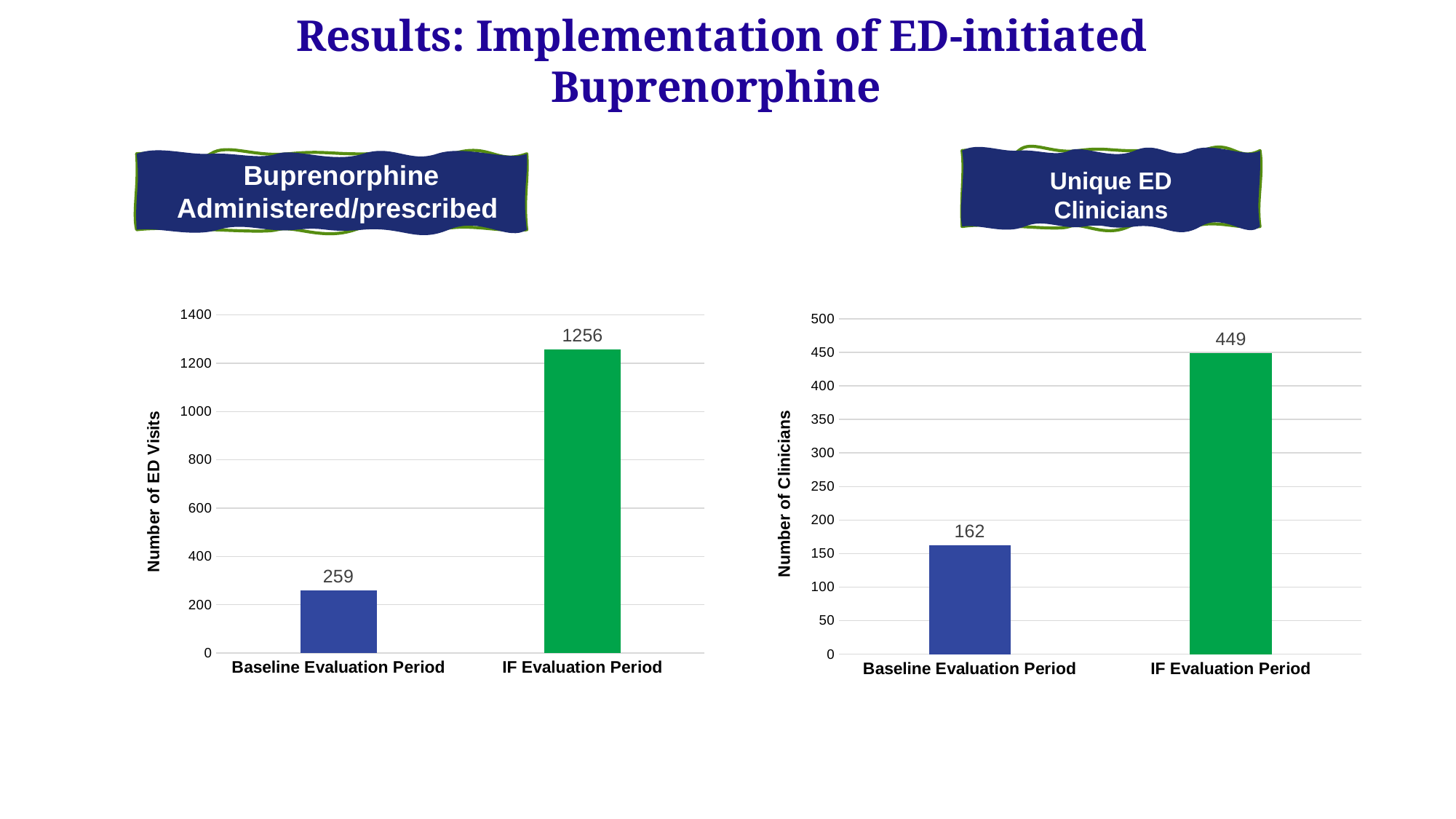
In the Unique ED Clinicians chart, which period has the lowest number of clinicians? Baseline Evaluation Period In the Unique ED Clinicians chart, is the value for the Baseline Evaluation Period greater or less than 200? less How many categories are shown on the x axis of the Buprenorphine Administered/prescribed chart? 2 In the Buprenorphine Administered/prescribed chart, which period has the highest number of ED visits? IF Evaluation Period In the Unique ED Clinicians chart, what is the value for the Baseline Evaluation Period? 162 What is the y-axis label of the Buprenorphine Administered/prescribed chart? Number of ED Visits In the Unique ED Clinicians chart, what is the value for the IF Evaluation Period? 449 In the Buprenorphine Administered/prescribed chart, what is the difference between the IF Evaluation Period and the Baseline Evaluation Period? 997 What kind of chart is the Unique ED Clinicians chart? bar chart In the Buprenorphine Administered/prescribed chart, what is the value for the IF Evaluation Period? 1256 In the Unique ED Clinicians chart, what is the difference between the IF Evaluation Period and the Baseline Evaluation Period? 287 In the Buprenorphine Administered/prescribed chart, what is the value for the Baseline Evaluation Period? 259